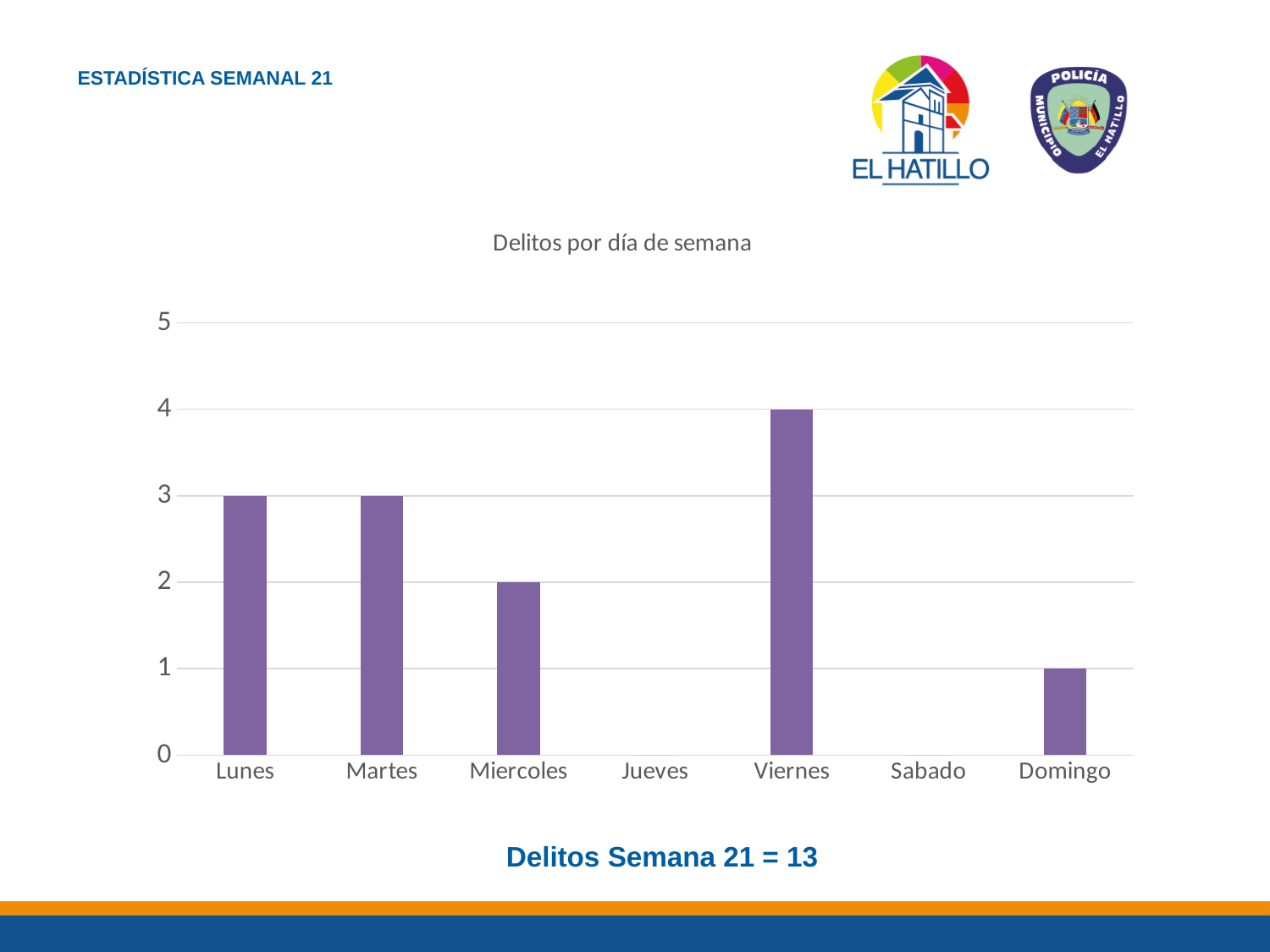
What kind of chart is shown on the slide? bar chart How many days are shown on the x axis of the chart? 7 Is the value for Viernes greater or less than 3? greater What is the title of the chart? Delitos por día de semana Which days show no bar in the chart? Jueves and Sabado Which day has the highest value in the chart? Viernes What is the difference between the values for Viernes and Domingo? 3 What is the value for Viernes in the chart? 4 What is the value for Miercoles in the chart? 2 What is the value for Domingo in the chart? 1 What is the value for Lunes in the chart? 3 Which is larger, the value for Martes or the value for Miercoles? Martes